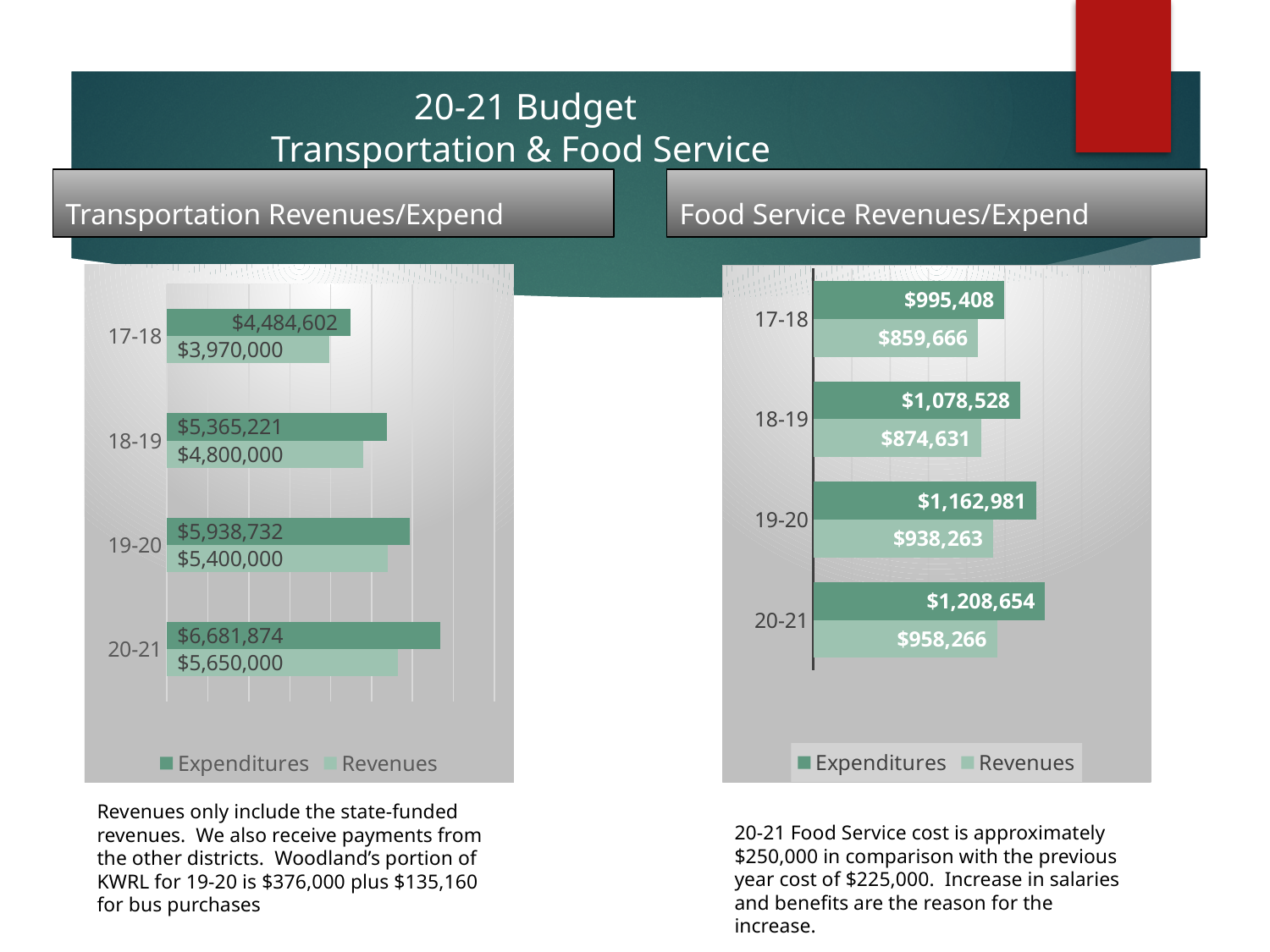
In the Transportation Revenues/Expend chart, what is the difference between Expenditures and Revenues for 20-21? $1,031,874 How many years are shown in the Transportation Revenues/Expend chart? 4 What kind of chart is the Transportation Revenues/Expend chart? Bar chart In the Transportation Revenues/Expend chart, which year has the highest Expenditures? 20-21 How many series does the legend of the Food Service Revenues/Expend chart list? 2 In the Food Service Revenues/Expend chart, what is the difference between Expenditures and Revenues for 20-21? $250,388 In the Food Service Revenues/Expend chart, which year has the lowest Revenues? 17-18 In the Transportation Revenues/Expend chart, what are the Expenditures for 20-21? $6,681,874 In the Food Service Revenues/Expend chart, what are the Expenditures for 19-20? $1,162,981 In the Food Service Revenues/Expend chart, what are the Revenues for 17-18? $859,666 In the Transportation Revenues/Expend chart, what are the Revenues for 18-19? $4,800,000 In the Food Service Revenues/Expend chart, which is larger for 18-19, Expenditures or Revenues? Expenditures